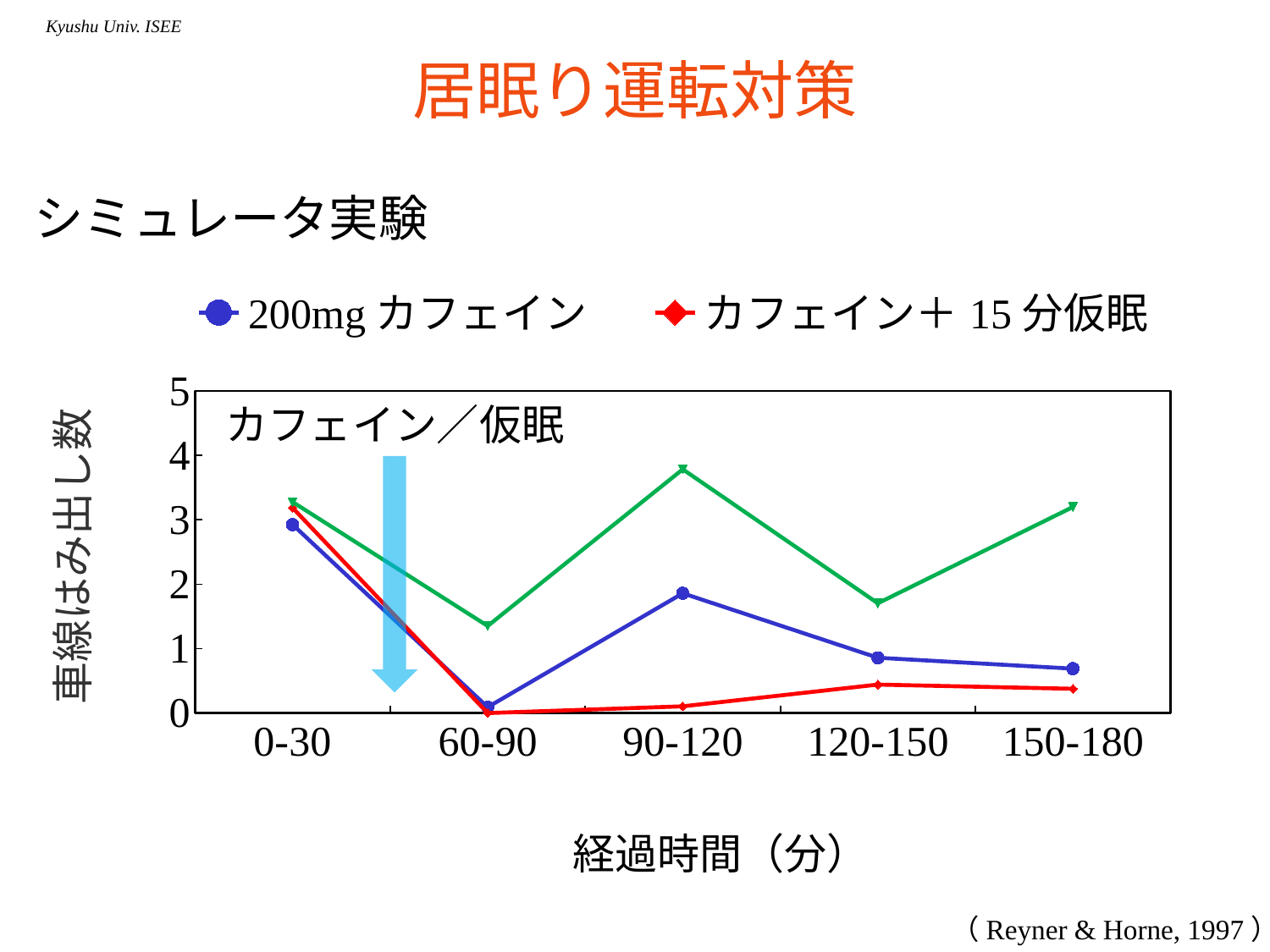
Is the value for 200mg カフェイン at 60-90 greater or less than 1? less At 90-120, which series has the larger value: 200mg カフェイン or カフェイン＋15分仮眠? 200mg カフェイン Is the value for 200mg カフェイン at 0-30 greater or less than 2? greater How many time-interval categories are shown on the x axis? 5 How many series does the legend list? 2 At which time interval is the 200mg カフェイン series highest? 0-30 At which time interval is the 200mg カフェイン series lowest? 60-90 Is the value for カフェイン＋15分仮眠 at 90-120 greater or less than 1? less What is the x-axis title of the chart? 経過時間（分） What kind of chart is shown on the slide? line chart Does the 200mg カフェイン series rise or fall from 90-120 to 150-180? fall